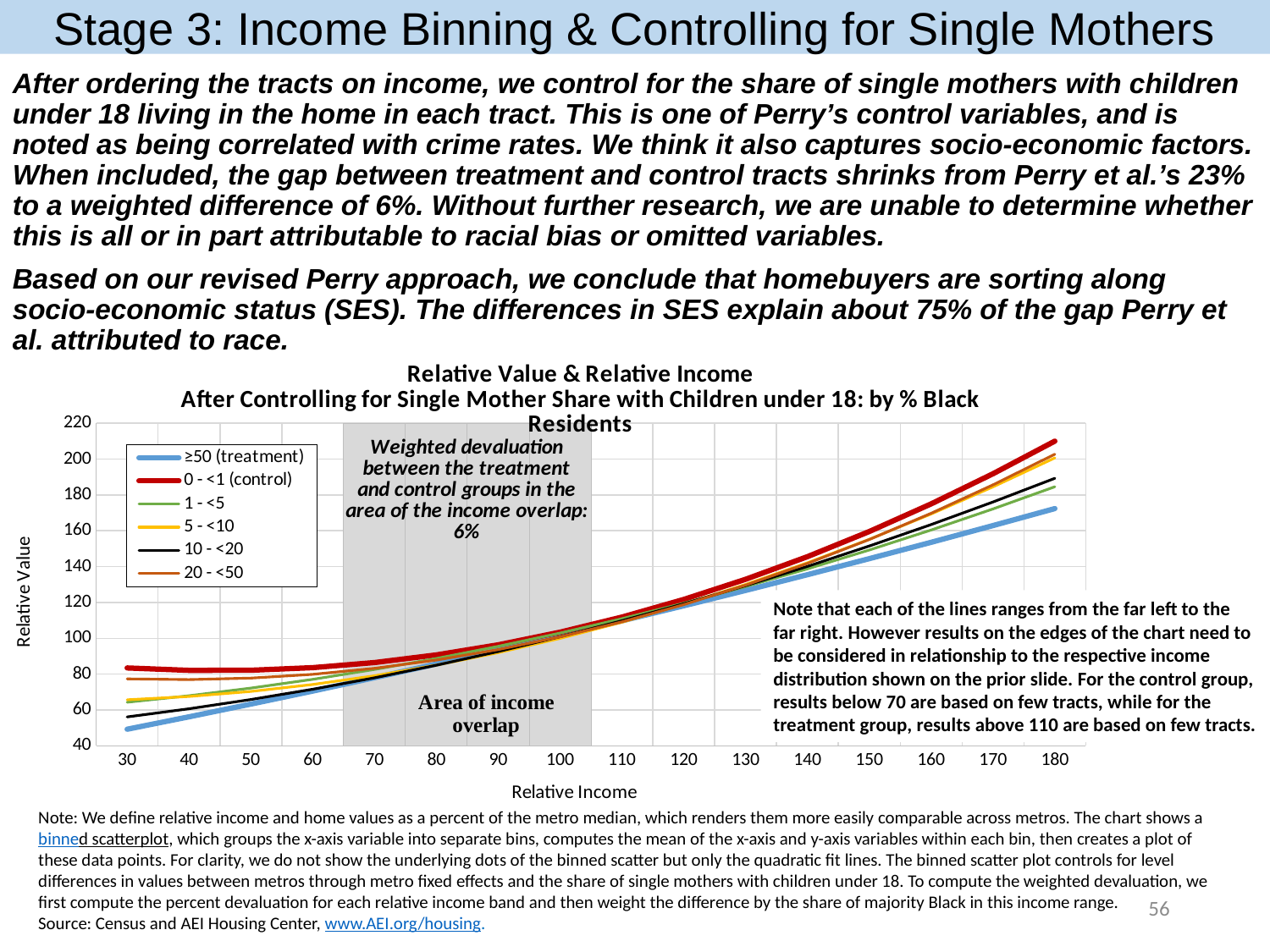
Which legend entry is labelled as the treatment group? ≥50 (treatment) What is the label of the x axis of the chart? Relative Income What kind of chart is shown on the slide? Line chart Which series has the highest relative value at a relative income of 180? 0 - <1 (control) Which series has the lowest relative value at a relative income of 30? ≥50 (treatment) How many series does the chart legend list? 6 Is the relative value of the ≥50 (treatment) series at a relative income of 30 greater or less than 60? less Which series has the lowest relative value at a relative income of 180? ≥50 (treatment) Which series has the highest relative value at a relative income of 30? 0 - <1 (control) Is the relative value of the 0 - <1 (control) series at a relative income of 180 greater or less than 200? greater Do the relative value lines rise or fall as relative income increases along the x axis? Rise At a relative income of 180, which series has the larger relative value: 0 - <1 (control) or 1 - <5? 0 - <1 (control)